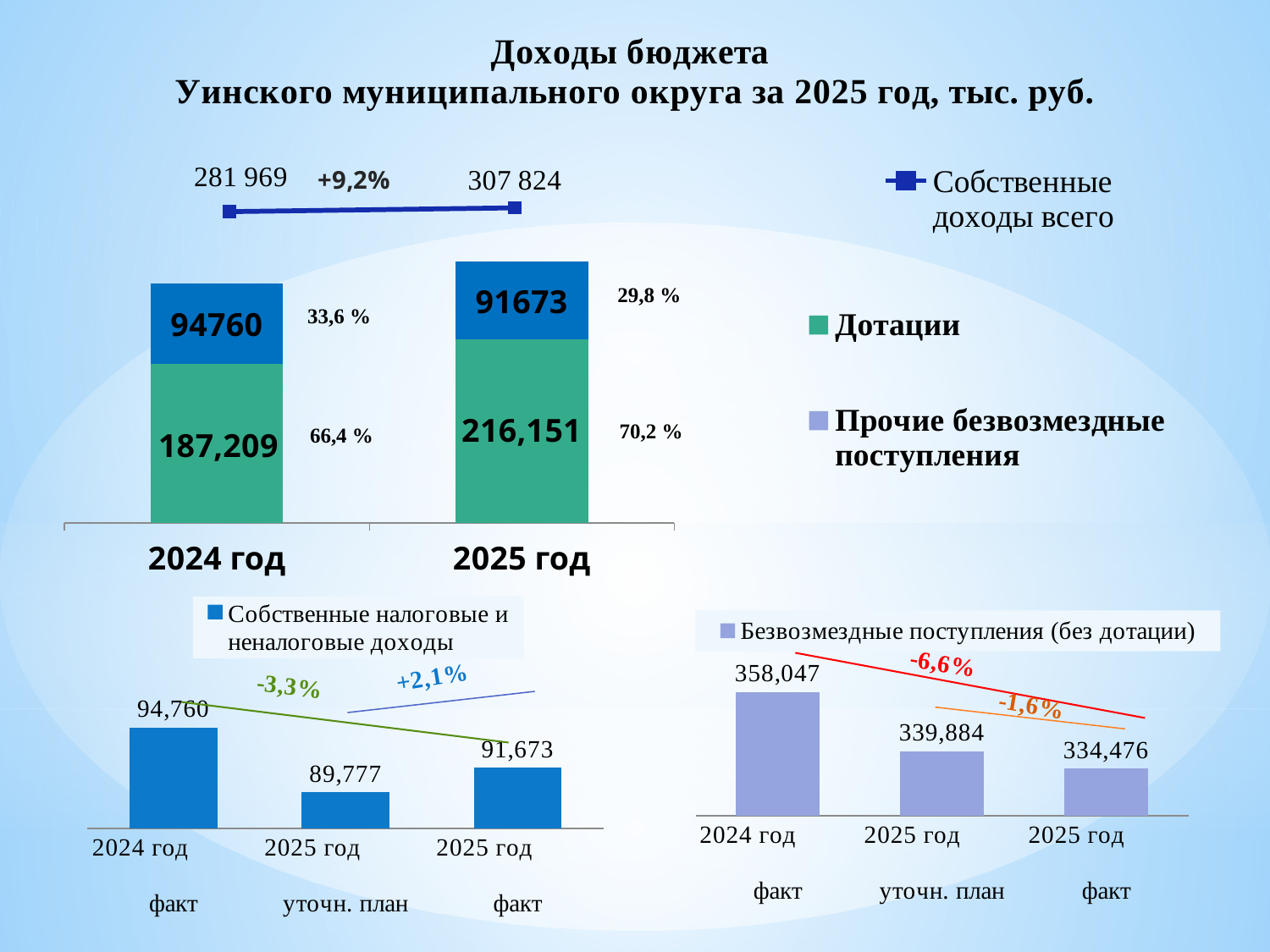
In the top stacked bar chart, what is the value of the green segment for 2025 год? 216,151 In the top stacked bar chart, what is the value of the blue segment for 2024 год? 94760 In the top stacked bar chart, what percentage change is shown between the 2024 and 2025 totals? +9,2% In the top stacked bar chart, how many entries does the legend list? 3 In the bottom-right chart 'Безвозмездные поступления (без дотации)', how many bars are plotted? 3 In the bottom-left chart 'Собственные налоговые и неналоговые доходы', what kind of chart is it? bar chart In the top stacked bar chart, what total is shown above the 2025 год bar? 307 824 In the bottom-right chart 'Безвозмездные поступления (без дотации)', what is the value for 2024 год факт? 358,047 In the bottom-left chart 'Собственные налоговые и неналоговые доходы', what is the value for 2025 год уточн. план? 89,777 In the bottom-left chart 'Собственные налоговые и неналоговые доходы', which category has the highest value? 2024 год факт In the bottom-right chart 'Безвозмездные поступления (без дотации)', which category has the lowest value? 2025 год факт In the top stacked bar chart, what percentage share is shown next to the green segment for 2024 год? 66,4 %